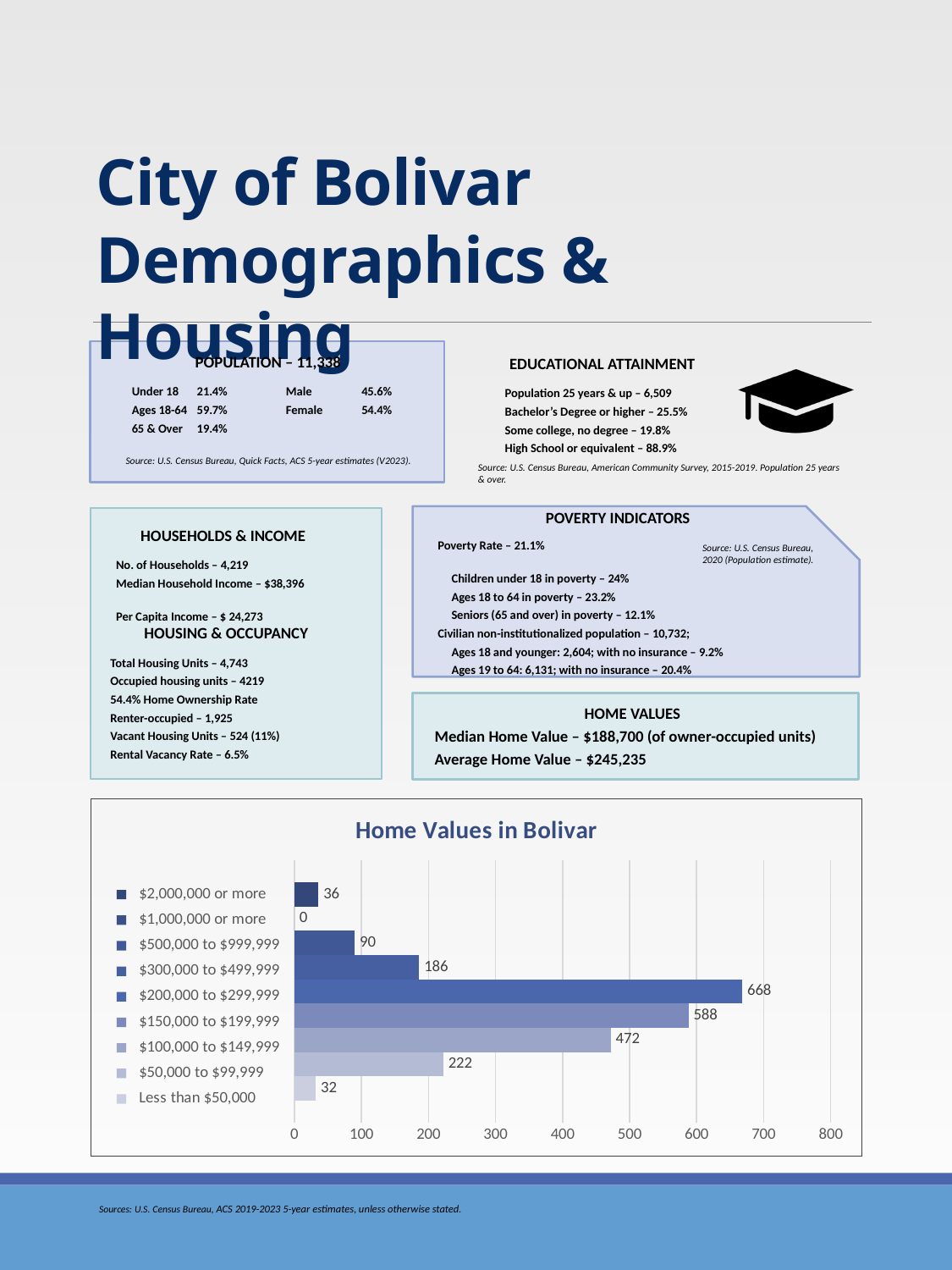
In the Home Values in Bolivar chart, what is the value for Less than $50,000? 32 What is the title of the chart on the slide? Home Values in Bolivar In the Home Values in Bolivar chart, how many homes are valued at $200,000 to $299,999? 668 In the Home Values in Bolivar chart, what is the value for $100,000 to $149,999? 472 In the Home Values in Bolivar chart, which category has the lowest value? $1,000,000 or more What kind of chart is the Home Values in Bolivar chart? bar chart How many categories are shown in the Home Values in Bolivar chart? 9 In the Home Values in Bolivar chart, what is the difference between the values for $200,000 to $299,999 and $150,000 to $199,999? 80 In the Home Values in Bolivar chart, what is the difference between the values for $500,000 to $999,999 and $2,000,000 or more? 54 In the Home Values in Bolivar chart, is the value for $150,000 to $199,999 greater or less than 500? greater In the Home Values in Bolivar chart, which is larger: the value for $50,000 to $99,999 or the value for $300,000 to $499,999? $50,000 to $99,999 In the Home Values in Bolivar chart, which category has the highest value? $200,000 to $299,999